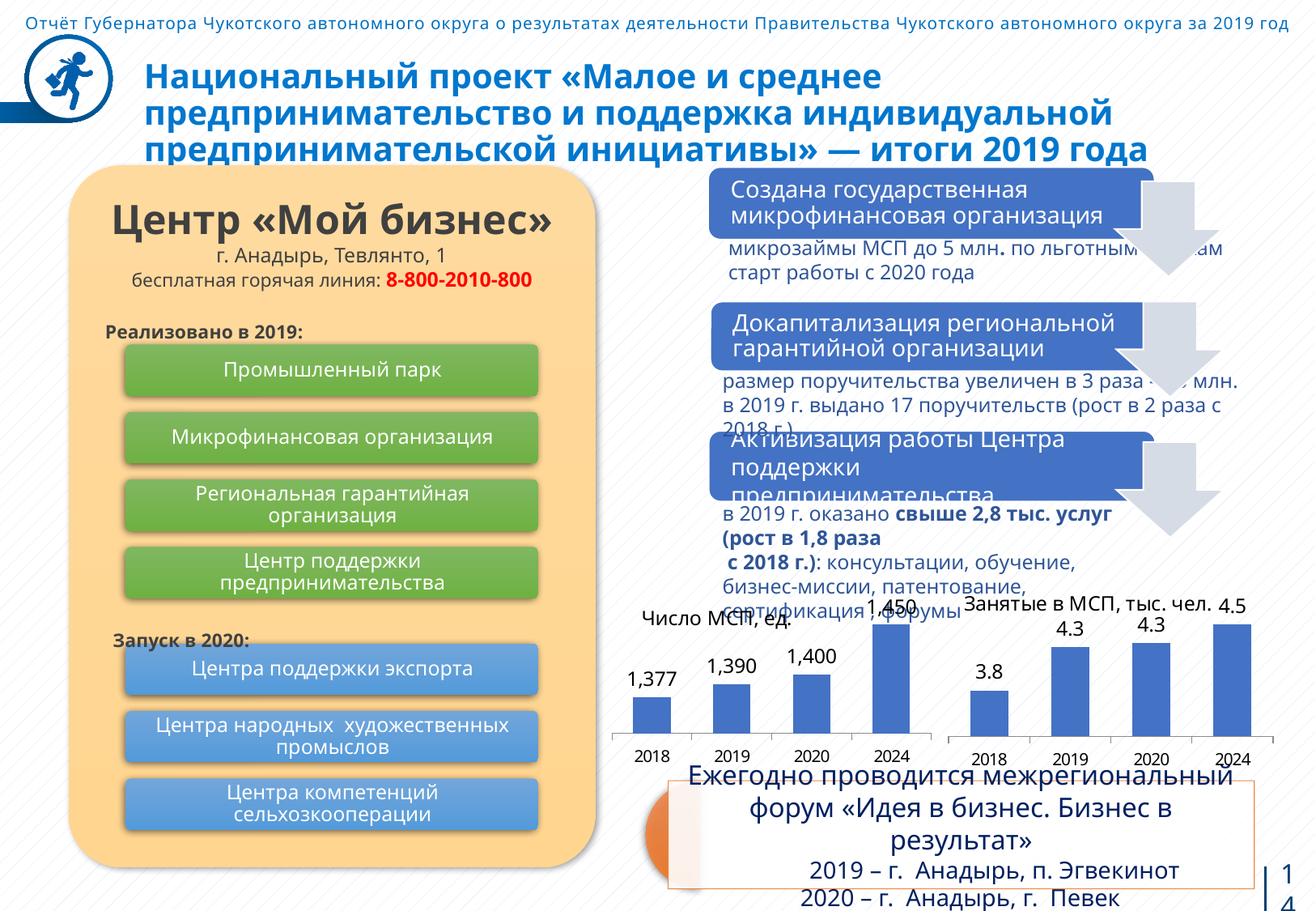
In the chart "Число МСП, ед.", do the values rise or fall from 2018 to 2024? rise What type of chart is "Занятые в МСП, тыс. чел."? bar chart In the chart "Число МСП, ед.", which year has the lowest value? 2018 In the chart "Число МСП, ед.", what is the value for 2024? 1,450 In the chart "Занятые в МСП, тыс. чел.", what is the difference between the 2019 and 2018 values? 0.5 In the chart "Занятые в МСП, тыс. чел.", what is the value for 2018? 3.8 In the chart "Число МСП, ед.", how many years are shown? 4 In the chart "Занятые в МСП, тыс. чел.", which is larger, the value for 2018 or the value for 2020? 2020 In the chart "Число МСП, ед.", what is the value for 2018? 1,377 In the chart "Занятые в МСП, тыс. чел.", what is the value for 2024? 4.5 In the chart "Занятые в МСП, тыс. чел.", which year has the highest value? 2024 In the chart "Число МСП, ед.", what is the difference between the 2024 and 2020 values? 50